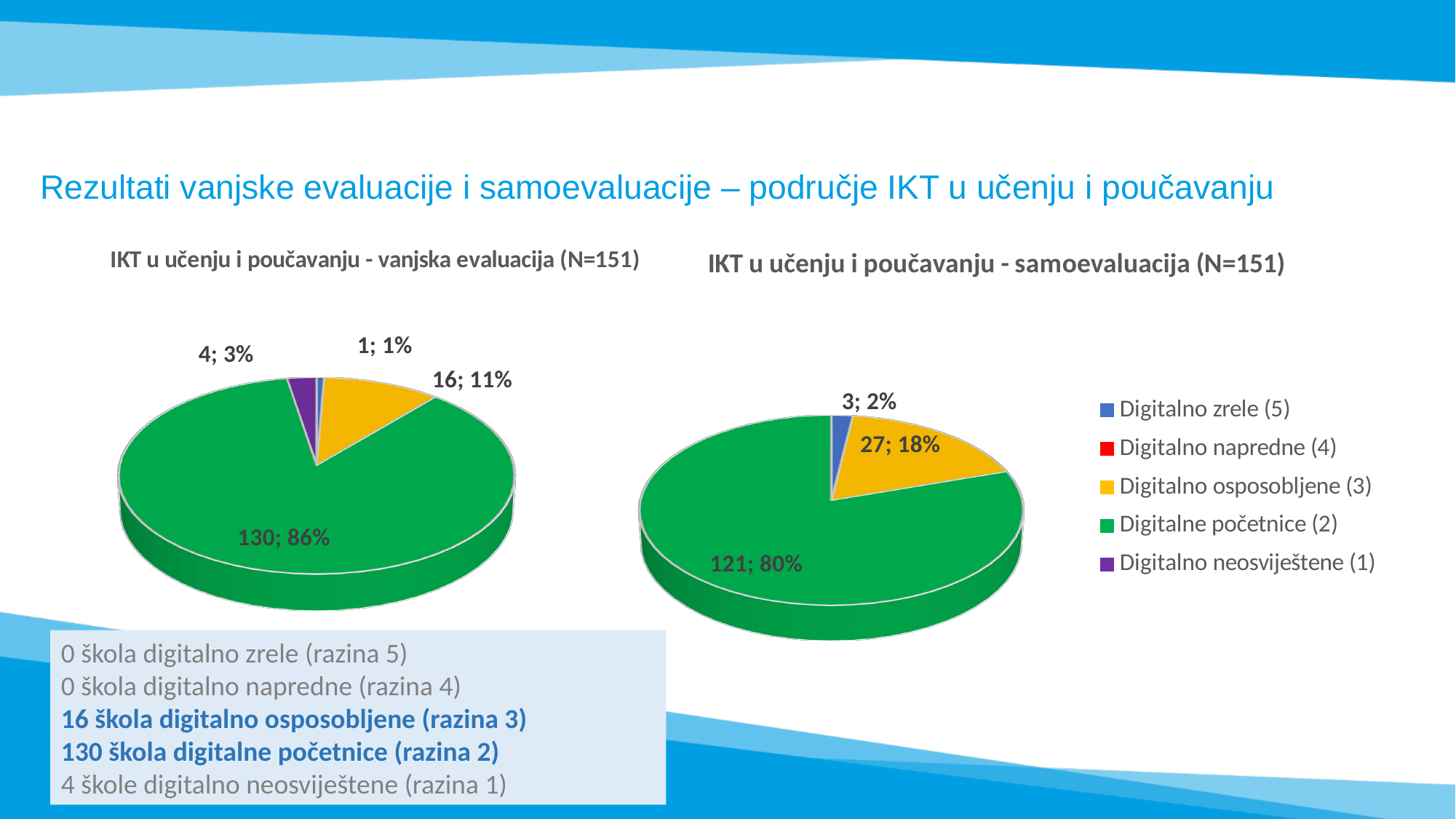
How many categories does the legend list? 5 What is the difference between the Digitalne početnice (2) count in the 'vanjska evaluacija' chart and in the 'samoevaluacija' chart? 9 In the 'samoevaluacija' chart, what is the value for Digitalne početnice (2)? 121; 80% In the 'vanjska evaluacija' chart, what is the value for Digitalno osposobljene (3)? 16; 11% What kind of charts are shown on the slide? Pie charts Which chart has the larger count for Digitalno osposobljene (3), 'vanjska evaluacija' or 'samoevaluacija'? samoevaluacija In the 'samoevaluacija' chart, what is the value for Digitalno osposobljene (3)? 27; 18% In the 'vanjska evaluacija' chart, what is the value for Digitalno neosviještene (1)? 4; 3% In the 'vanjska evaluacija' chart, which category has the largest slice? Digitalne početnice (2) In the 'vanjska evaluacija' chart, what is the value for Digitalne početnice (2)? 130; 86% In the 'samoevaluacija' chart, which category has the largest slice? Digitalne početnice (2) In the 'samoevaluacija' chart, what is the value for Digitalno zrele (5)? 3; 2%